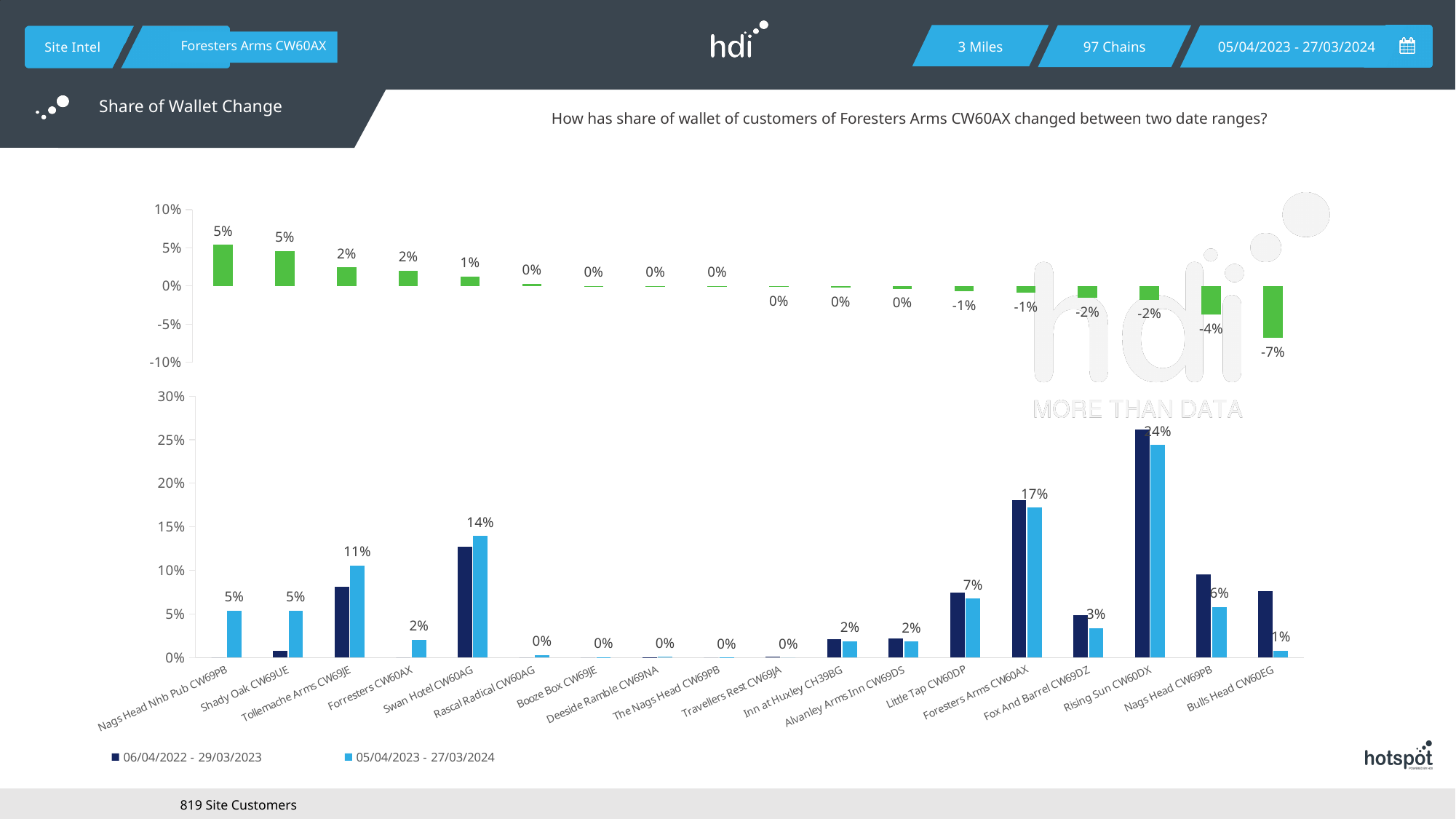
On the bottom chart, is the 06/04/2022 - 29/03/2023 value for Rising Sun CW60DX greater or less than 20%? greater On the top chart (share of wallet change), what is the value for Bulls Head CW60EG? -7% What are the two legend entries on the bottom chart? 06/04/2022 - 29/03/2023 and 05/04/2023 - 27/03/2024 How many series does the legend of the bottom chart list? 2 On the bottom chart, what is the 05/04/2023 - 27/03/2024 value for Rising Sun CW60DX? 24% How many categories are shown on the x axis of the bottom chart? 18 On the bottom chart, which category has the highest value in the 05/04/2023 - 27/03/2024 series? Rising Sun CW60DX On the bottom chart, in the 05/04/2023 - 27/03/2024 series, which is larger: Foresters Arms CW60AX or Swan Hotel CW60AG? Foresters Arms CW60AX On the top chart (share of wallet change), which category has the lowest value? Bulls Head CW60EG On the bottom chart, what is the difference between the 05/04/2023 - 27/03/2024 values for Rising Sun CW60DX and Foresters Arms CW60AX? 7% On the top chart (share of wallet change), what is the value for Nags Head CW69PB? -4% What kind of chart is the bottom chart? Bar chart